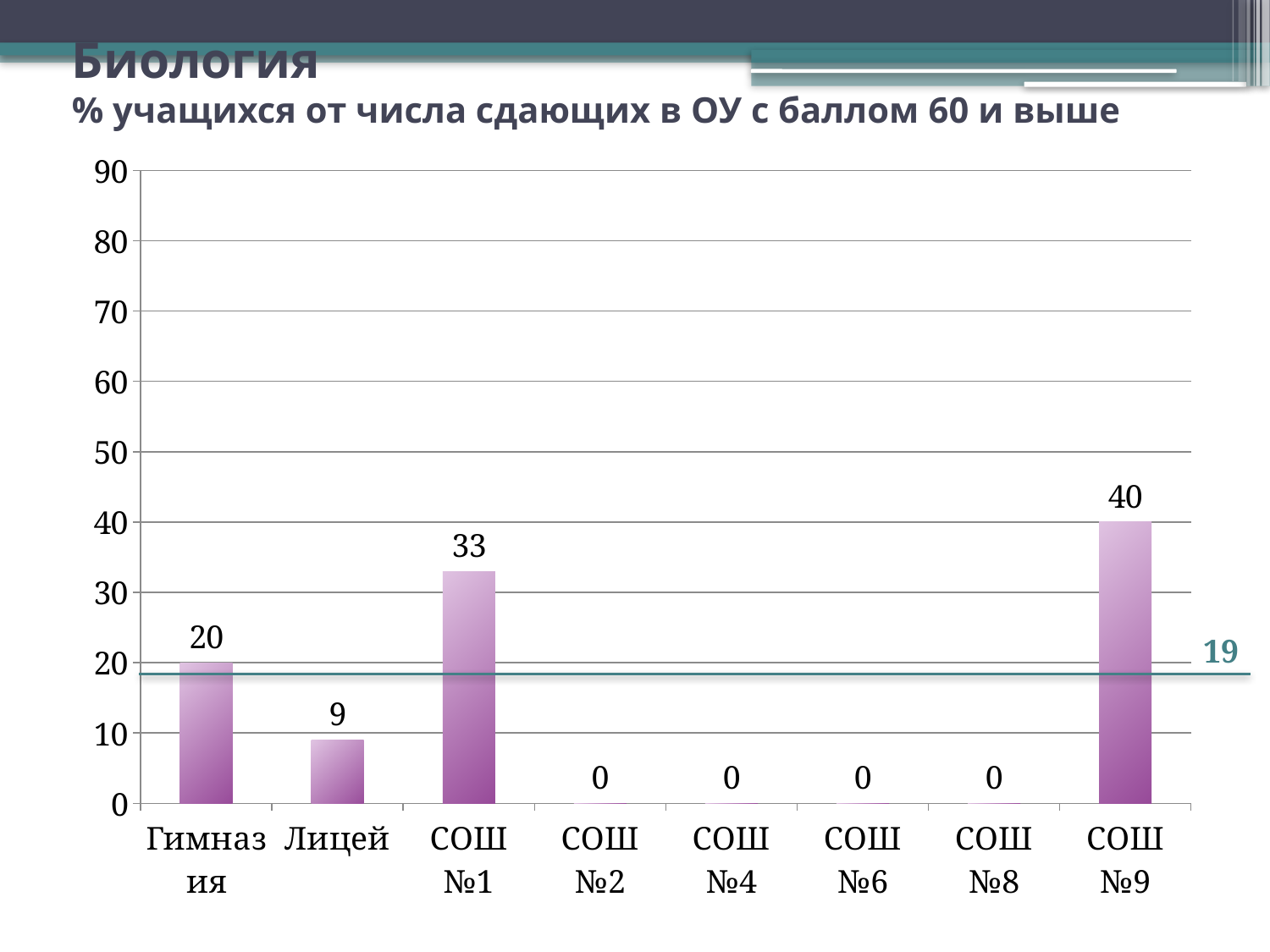
What kind of chart is shown on the slide? bar chart What value is marked by the horizontal line across the chart? 19 What is the value for Гимназия? 20 What is the value for Лицей? 9 How many categories are shown on the x axis? 8 What is the difference between the values for СОШ №9 and СОШ №1? 7 What is the subject named in the slide title? Биология What is the value for СОШ №1? 33 Which category has the highest value? СОШ №9 Which is larger, the value for Гимназия or the value for Лицей? Гимназия What is the difference between the values for Гимназия and Лицей? 11 How many categories have a value of 0? 4